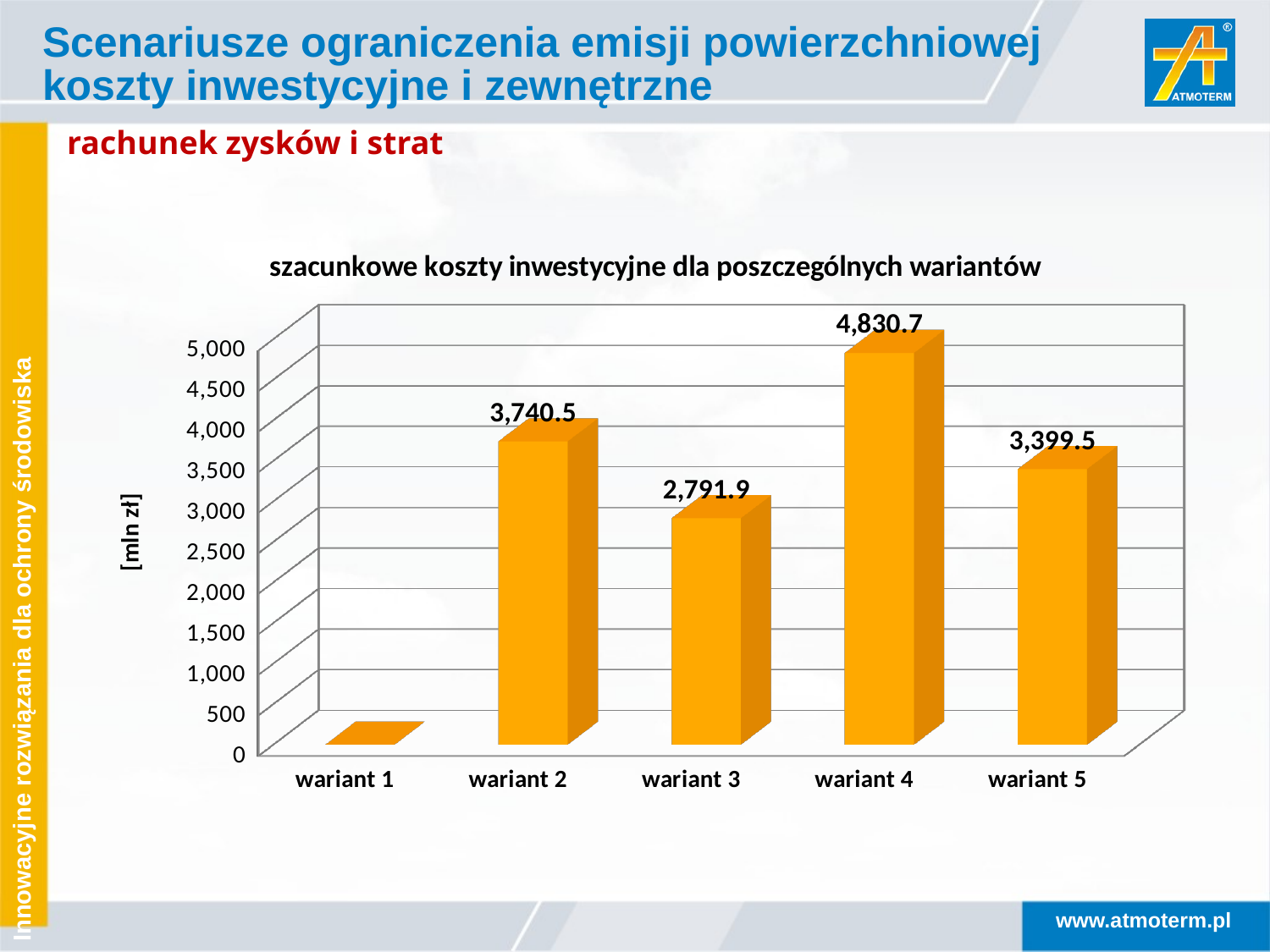
How many wariant categories are shown on the chart? 5 What unit is shown on the vertical axis of the chart? [mln zł] Which is larger, the value for wariant 3 or the value for wariant 5? wariant 5 What is the difference between the values for wariant 5 and wariant 3? 607.6 What is the value for wariant 3? 2,791.9 What is the value for wariant 2? 3,740.5 What is the value for wariant 5? 3,399.5 What is the value for wariant 4? 4,830.7 Which wariant has the lowest estimated investment cost? wariant 1 Which wariant has the highest estimated investment cost? wariant 4 Is the value for wariant 1 greater or less than 500? less What is the difference between the values for wariant 4 and wariant 2? 1,090.2